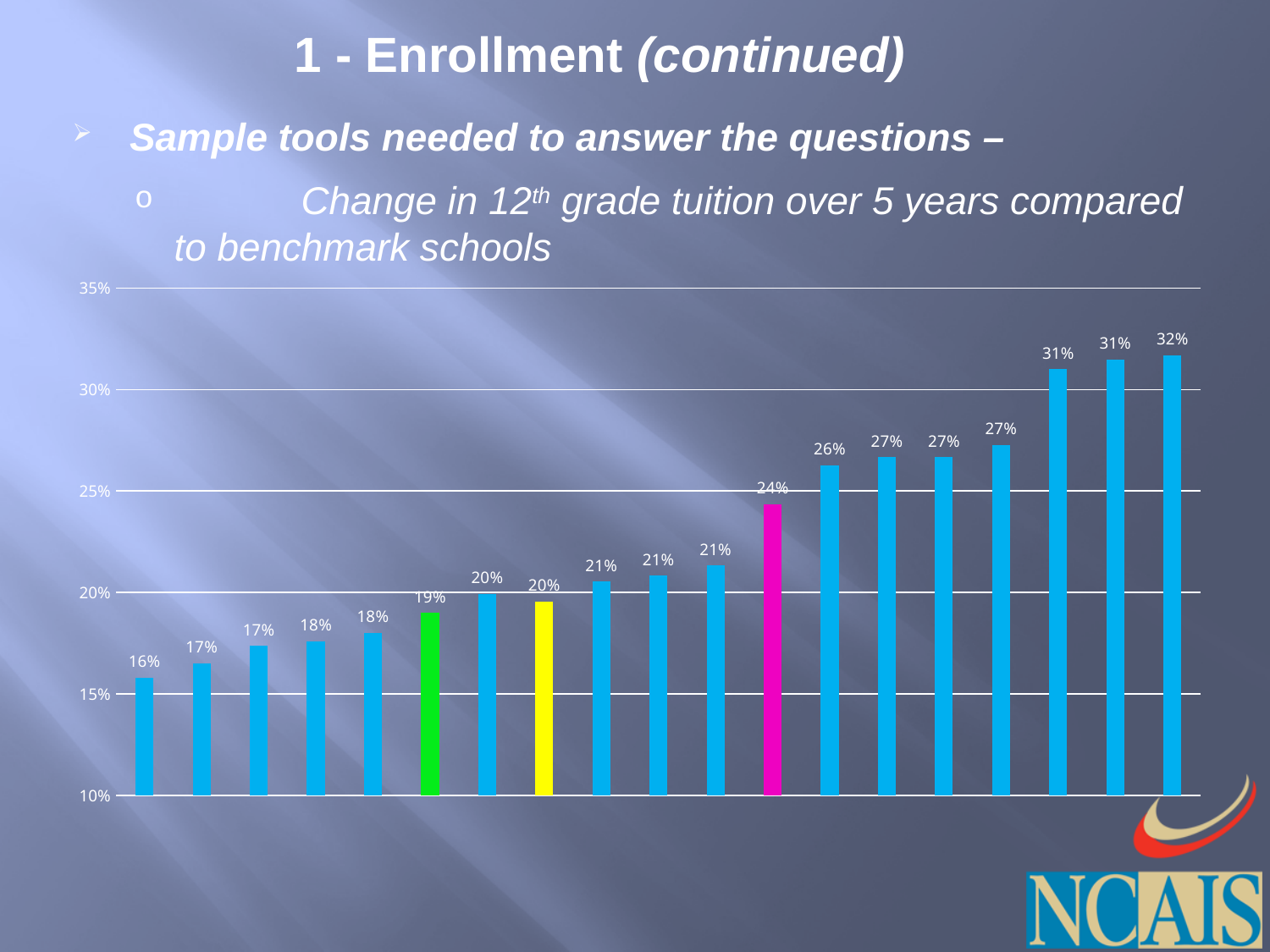
What is the value shown on the green bar? 19% How many bars are plotted in the chart? 19 What is the value of the tallest bar in the chart? 32% What is the highest value labelled on the vertical axis? 35% Is the value of the magenta bar greater or less than 25%? less Do the bar values rise or fall from left to right across the chart? rise What is the value shown on the magenta bar? 24% What is the value shown on the yellow bar? 20% Which is larger, the value of the magenta bar or the value of the green bar? the magenta bar What is the difference between the tallest bar (32%) and the shortest bar (16%)? 16% What is the value of the shortest bar in the chart? 16% What kind of chart is shown on the slide? bar chart